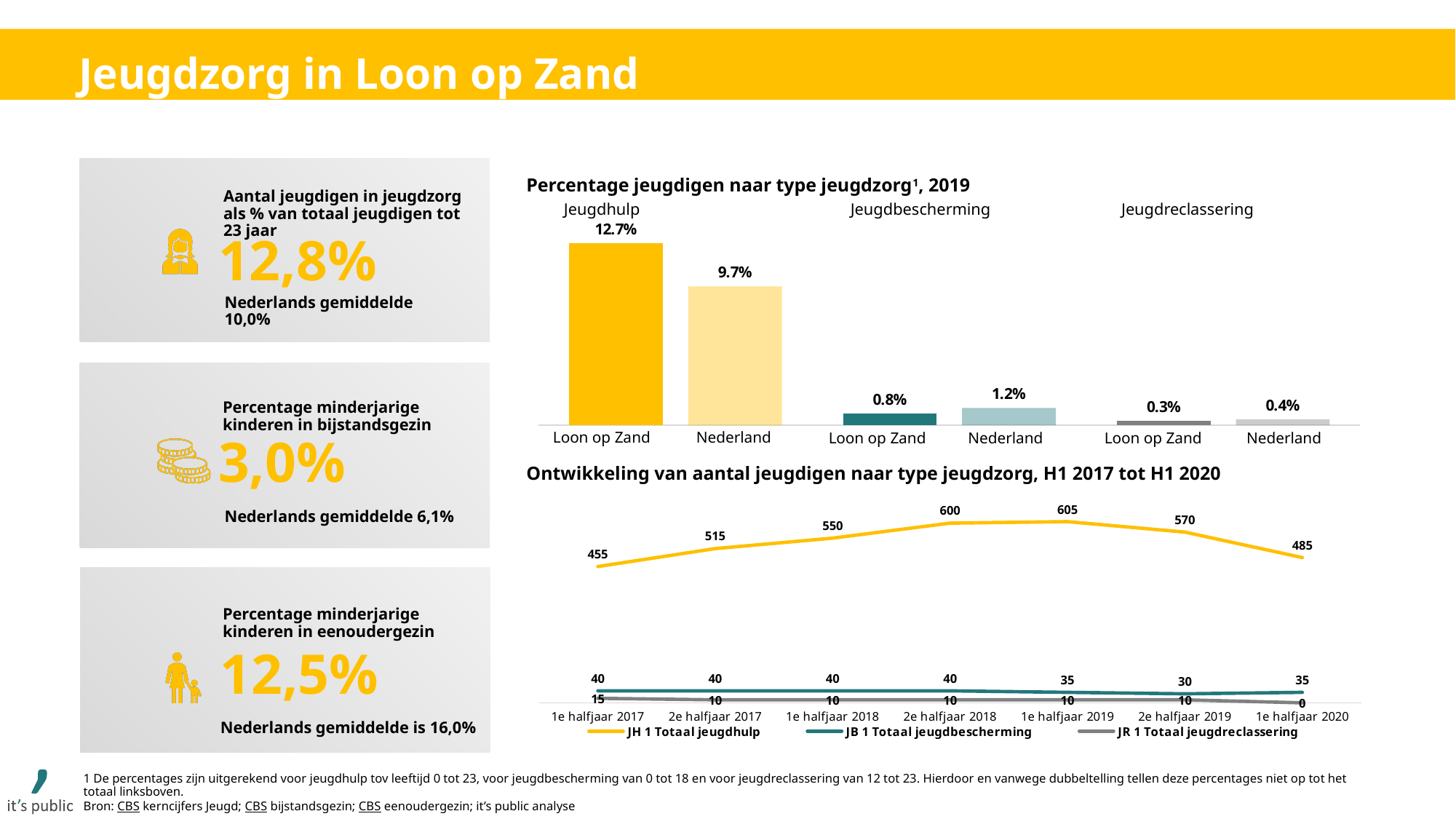
In the chart 'Percentage jeugdigen naar type jeugdzorg, 2019', is the Jeugdreclassering percentage higher for Loon op Zand or for Nederland? Nederland In the chart 'Percentage jeugdigen naar type jeugdzorg, 2019', what is the difference between the Jeugdhulp percentages for Loon op Zand and Nederland? 3.0% What kind of chart is 'Percentage jeugdigen naar type jeugdzorg, 2019'? Bar chart In the chart 'Percentage jeugdigen naar type jeugdzorg, 2019', what is the Jeugdbescherming percentage for Nederland? 1.2% In the chart 'Ontwikkeling van aantal jeugdigen naar type jeugdzorg, H1 2017 tot H1 2020', what is the value of JH 1 Totaal jeugdhulp in 1e halfjaar 2019? 605 In the chart 'Ontwikkeling van aantal jeugdigen naar type jeugdzorg, H1 2017 tot H1 2020', how many series does the legend list? 3 In the chart 'Percentage jeugdigen naar type jeugdzorg, 2019', which bar has the highest value? Jeugdhulp, Loon op Zand In the chart 'Ontwikkeling van aantal jeugdigen naar type jeugdzorg, H1 2017 tot H1 2020', in which period is JH 1 Totaal jeugdhulp lowest? 1e halfjaar 2017 In the chart 'Ontwikkeling van aantal jeugdigen naar type jeugdzorg, H1 2017 tot H1 2020', what is the value of JR 1 Totaal jeugdreclassering in 1e halfjaar 2020? 0 In the chart 'Ontwikkeling van aantal jeugdigen naar type jeugdzorg, H1 2017 tot H1 2020', what is the difference between JH 1 Totaal jeugdhulp in 2e halfjaar 2018 and 1e halfjaar 2020? 115 In the chart 'Percentage jeugdigen naar type jeugdzorg, 2019', what is the Jeugdhulp percentage for Loon op Zand? 12.7% In the chart 'Ontwikkeling van aantal jeugdigen naar type jeugdzorg, H1 2017 tot H1 2020', how many periods are shown on the x axis? 7